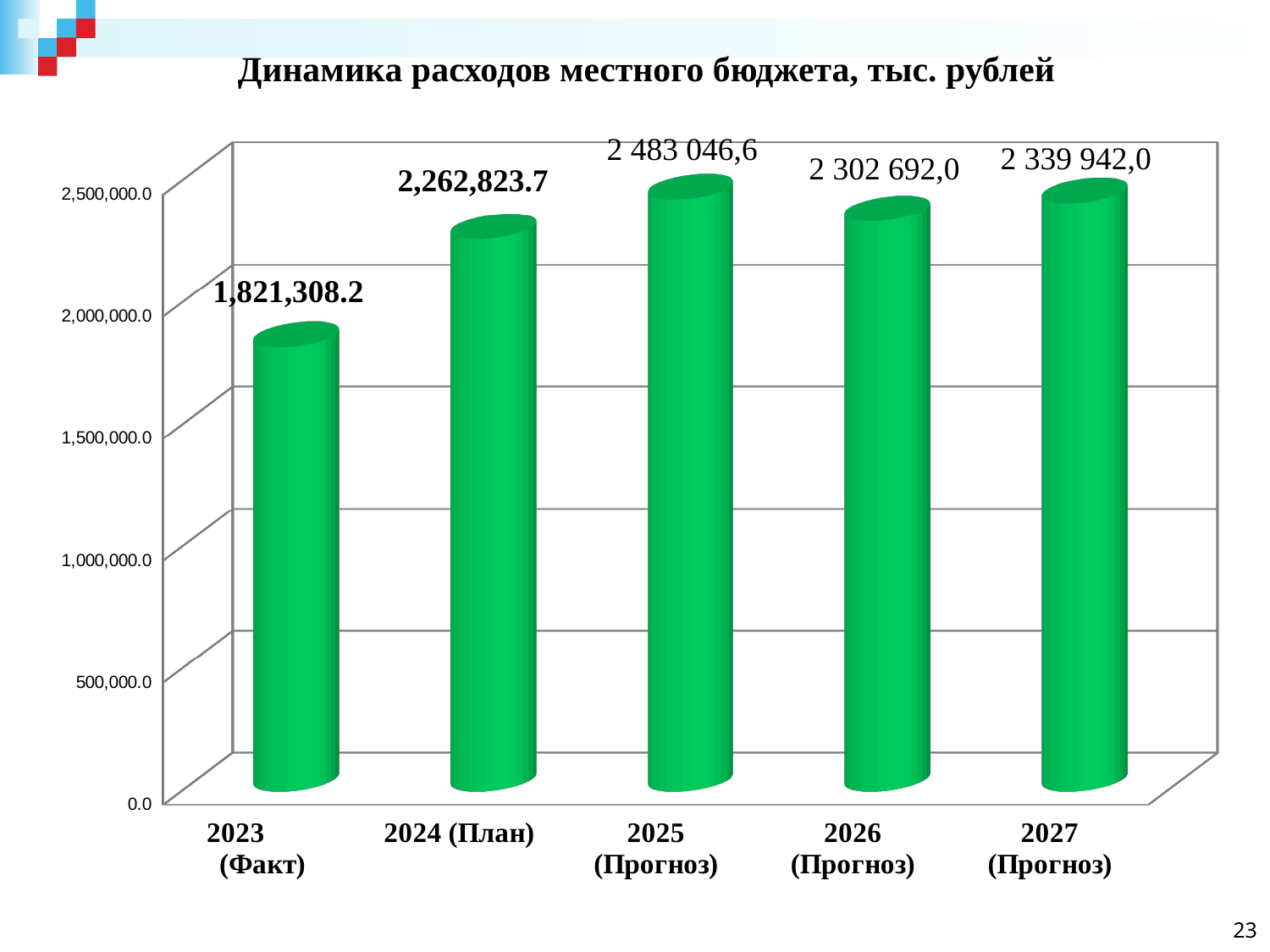
What is the title of the chart? Динамика расходов местного бюджета, тыс. рублей What is the value for 2027 (Прогноз)? 2 339 942,0 What is the difference between the values for 2024 (План) and 2023 (Факт)? 441,515.5 What is the value for 2023 (Факт)? 1,821,308.2 Which year has the lowest value? 2023 (Факт) What is the value for 2025 (Прогноз)? 2 483 046,6 Is the value for 2023 (Факт) greater or less than 2,000,000.0? less How many years are shown on the chart? 5 Which year has the highest value? 2025 (Прогноз) What is the value for 2024 (План)? 2,262,823.7 Which is larger, the value for 2026 (Прогноз) or 2027 (Прогноз)? 2027 (Прогноз) What is the difference between the values for 2025 (Прогноз) and 2026 (Прогноз)? 180 354,6